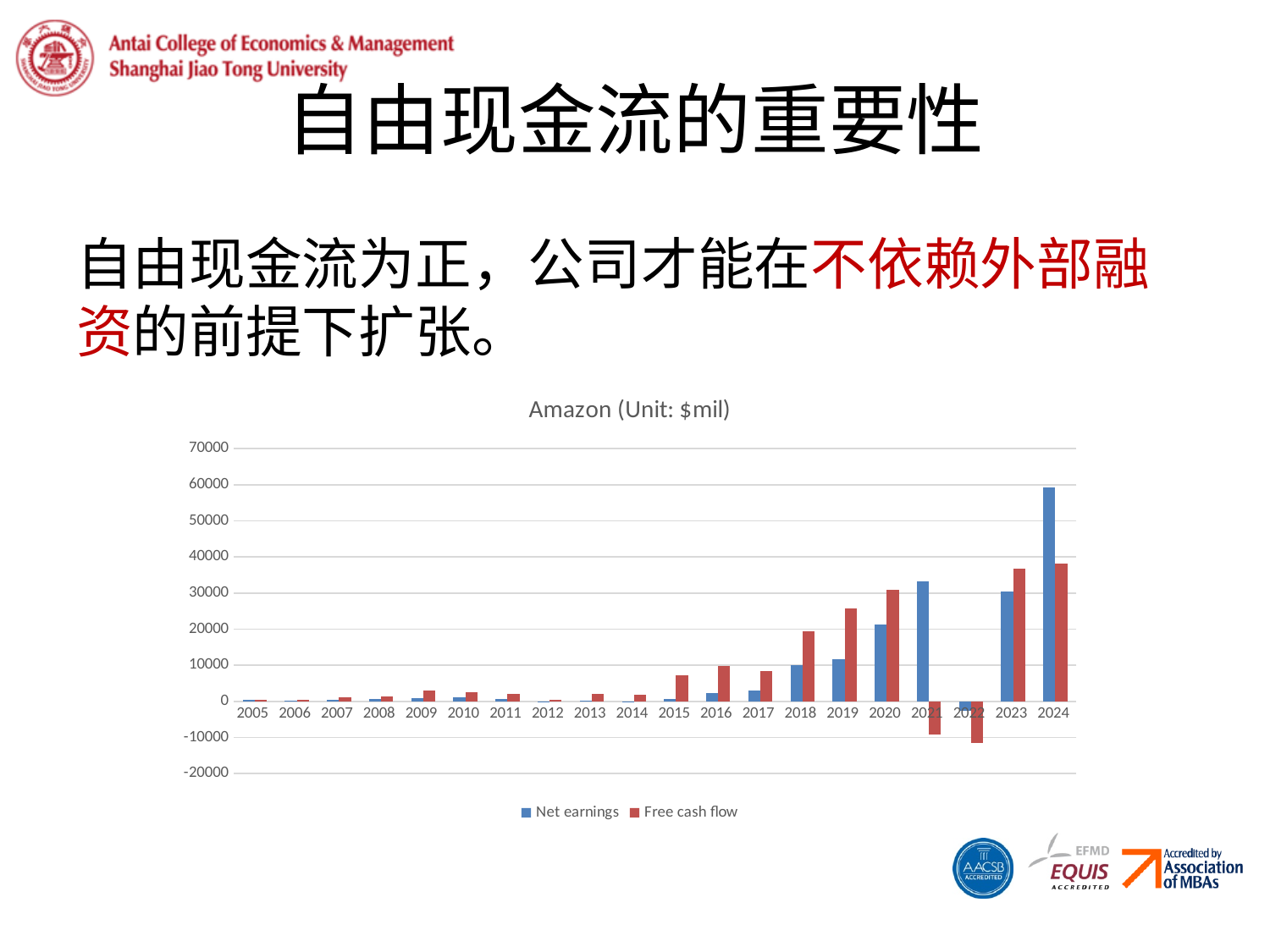
In 2020, which is larger: Net earnings or Free cash flow? Free cash flow How many series does the chart's legend list? 2 Is the value of Net earnings for 2024 greater or less than 50000? greater What type of chart is shown on the slide? Bar chart Is the value of Free cash flow for 2021 greater or less than 0? less Overall, do Net earnings rise or fall from 2005 to 2024? Rise In which year is Net earnings the highest? 2024 In which year is Free cash flow the lowest? 2022 Which colour represents Free cash flow in the chart? Red What is the title of the chart? Amazon (Unit: $mil) How many years are shown on the x axis of the chart? 20 Is the value of Free cash flow for 2019 greater or less than 20000? greater